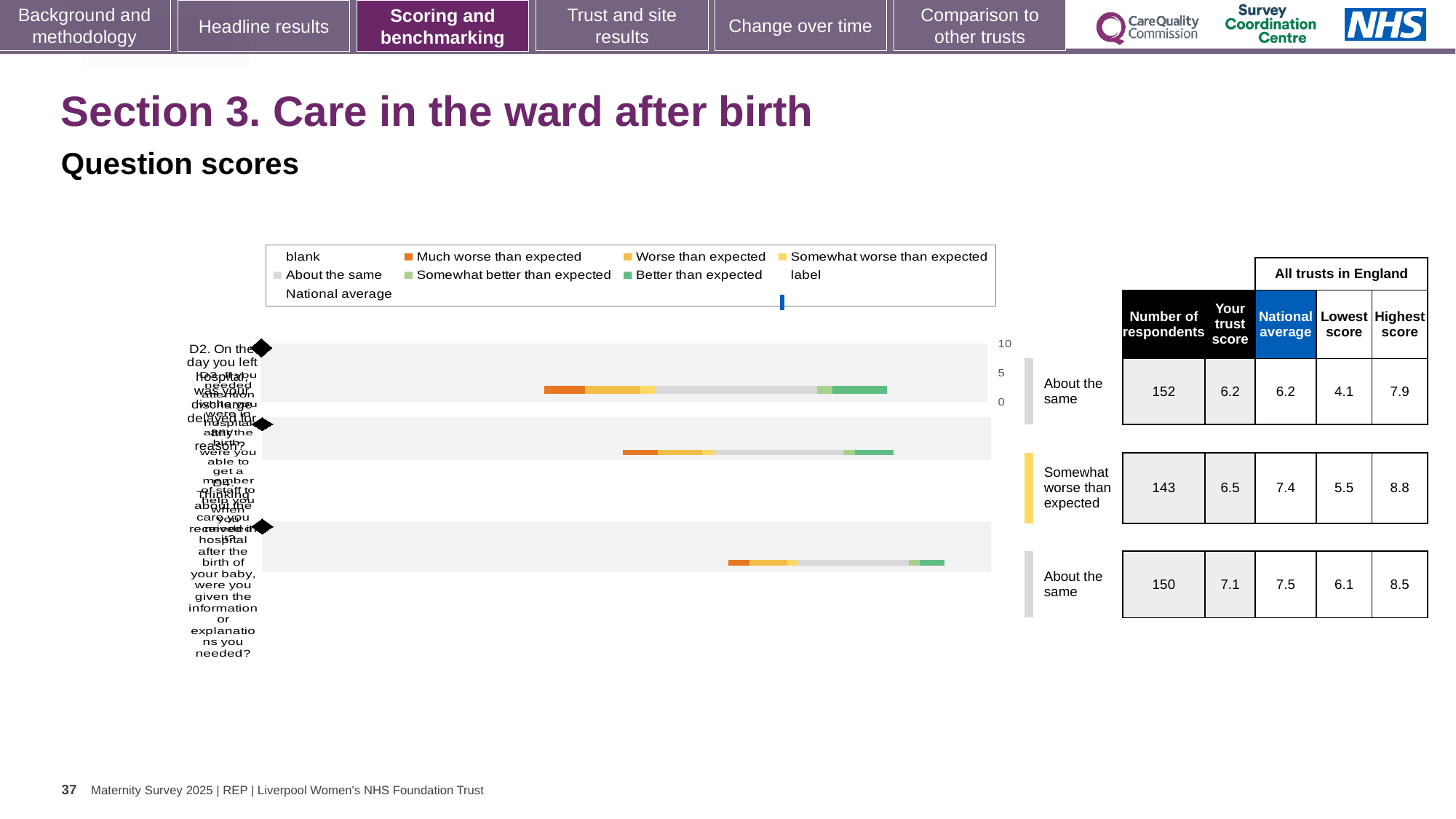
How many bars (question rows) are plotted in the chart? 3 In the table beside the chart, what is the highest score for the third row? 8.5 In the table beside the chart, what is the number of respondents for the first row? 152 What kind of chart is shown on the slide? bar chart In the table beside the chart, what is the difference between the national average and the trust score for the third row? 0.4 In the table beside the chart, what is the 'Your trust score' for the first row? 6.2 In the table beside the chart, what is the lowest score for the second row? 5.5 In the chart legend, which colour represents 'Much worse than expected'? orange In the table beside the chart, which is larger for the second row: the trust score or the national average? national average In the table beside the chart, which row has the highest number of respondents? first row (152) In the table beside the chart, what is the national average for the second row? 7.4 In the chart legend, which colour represents 'Better than expected'? green